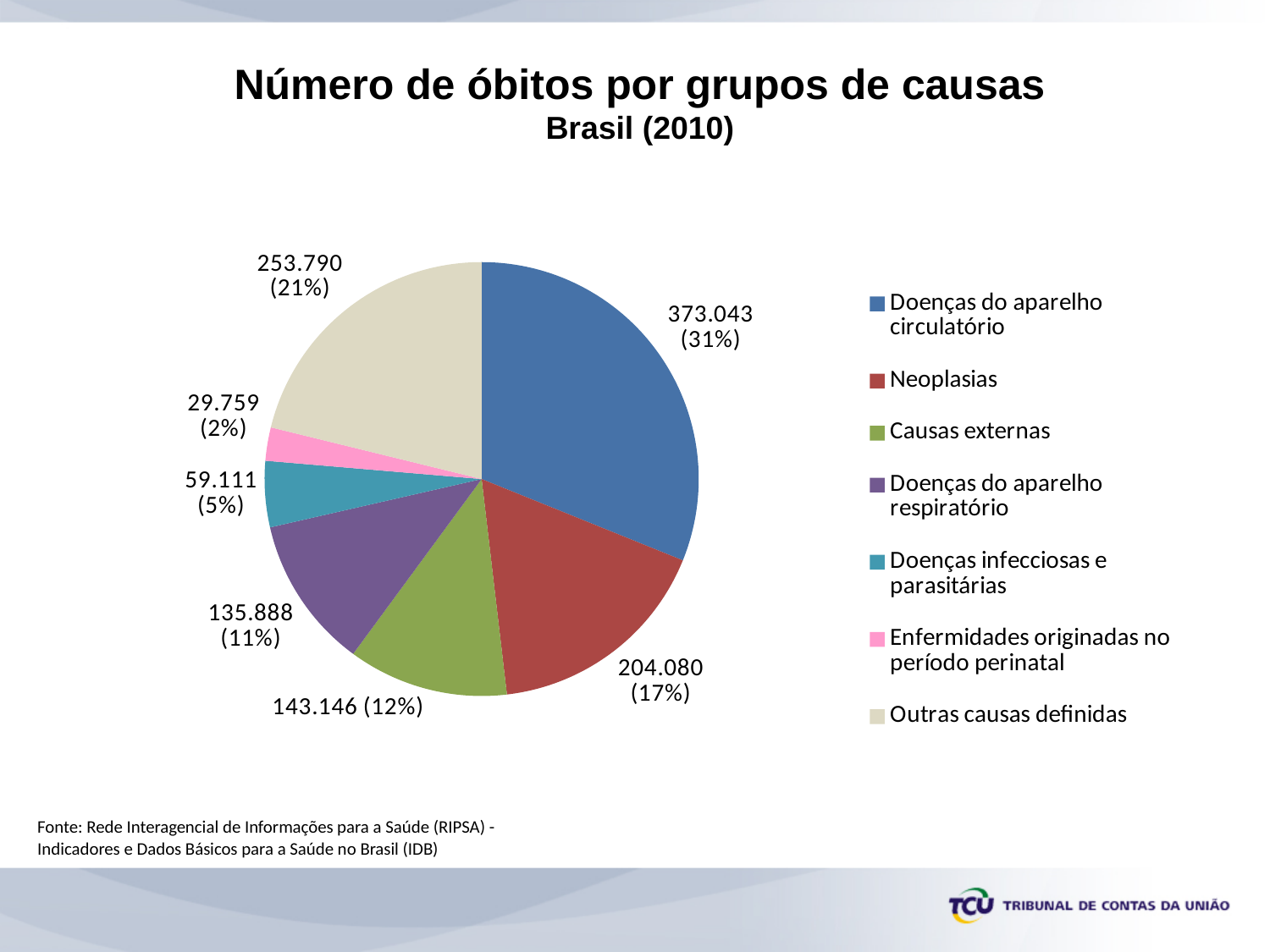
What is the number of deaths for Doenças do aparelho circulatório? 373.043 How many categories does the pie chart show? 7 What is the title of the chart? Número de óbitos por grupos de causas Brasil (2010) What type of chart is shown on the slide? Pie chart What is the difference between the values for Doenças do aparelho circulatório and Neoplasias? 168.963 What is the value shown for Causas externas? 143.146 What percentage is shown for Outras causas definidas? 21% What is the value shown for Doenças infecciosas e parasitárias? 59.111 Which category has the smallest slice of the pie? Enfermidades originadas no período perinatal What share of the pie does Neoplasias represent? 17% Which is larger, the value for Outras causas definidas or the value for Neoplasias? Outras causas definidas Which category has the largest slice of the pie? Doenças do aparelho circulatório